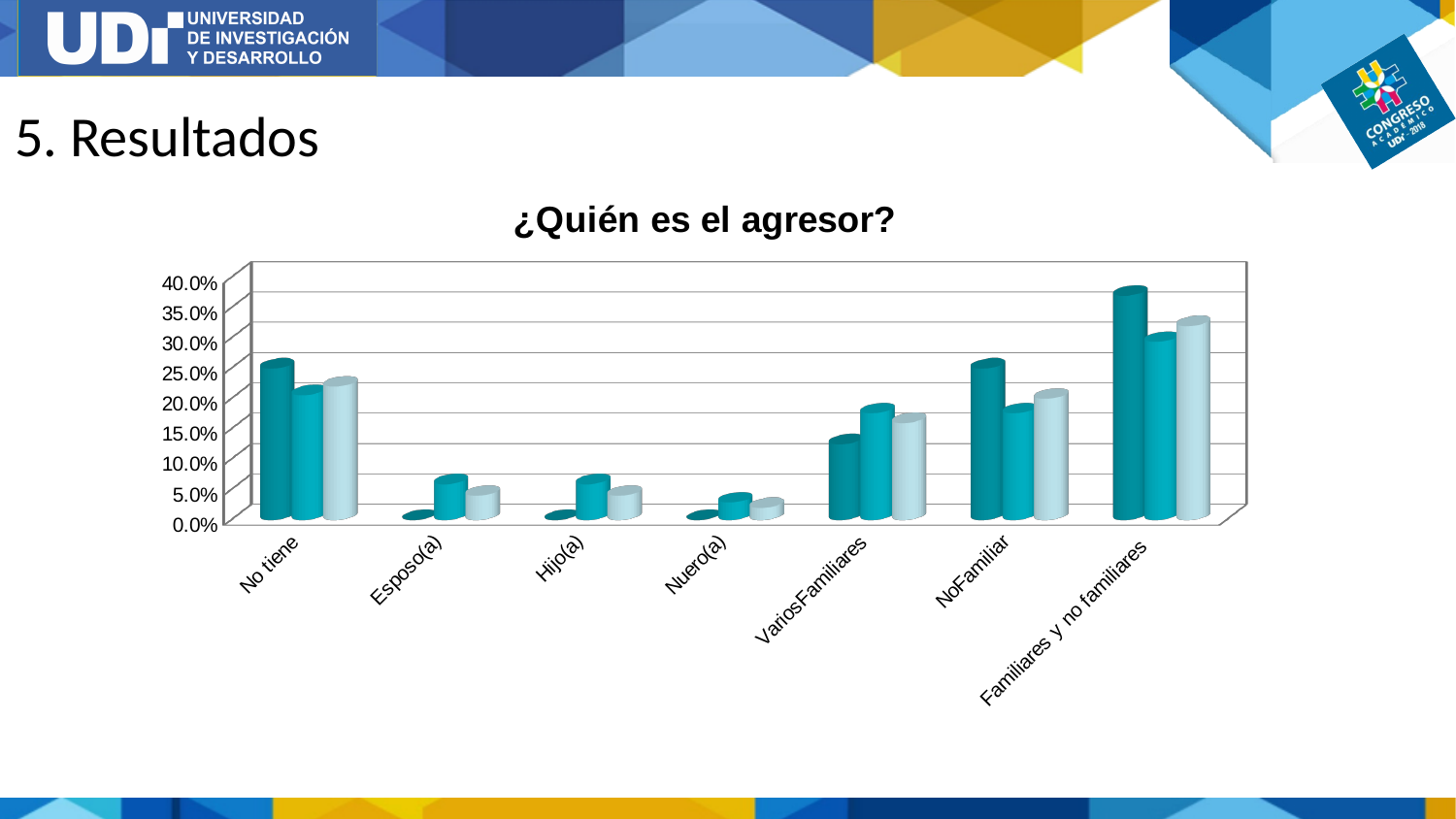
How many bars are plotted for each category in the chart? 3 Which category has the lowest bars in the chart? Nuero(a) Which category has higher bars, Familiares y no familiares or Nuero(a)? Familiares y no familiares What kind of chart is shown on the slide? bar chart How many categories are shown on the x axis of the chart? 7 Is the value of the tallest bar for Familiares y no familiares greater or less than 30%? greater Is the value of the first (dark teal) bar for No tiene greater or less than 20%? greater Is the value of the middle bar for Esposo(a) greater or less than 10%? less Which category has the tallest bar in the chart? Familiares y no familiares What is the title of the chart? ¿Quién es el agresor? Which has the higher first (dark teal) bar, No tiene or VariosFamiliares? No tiene